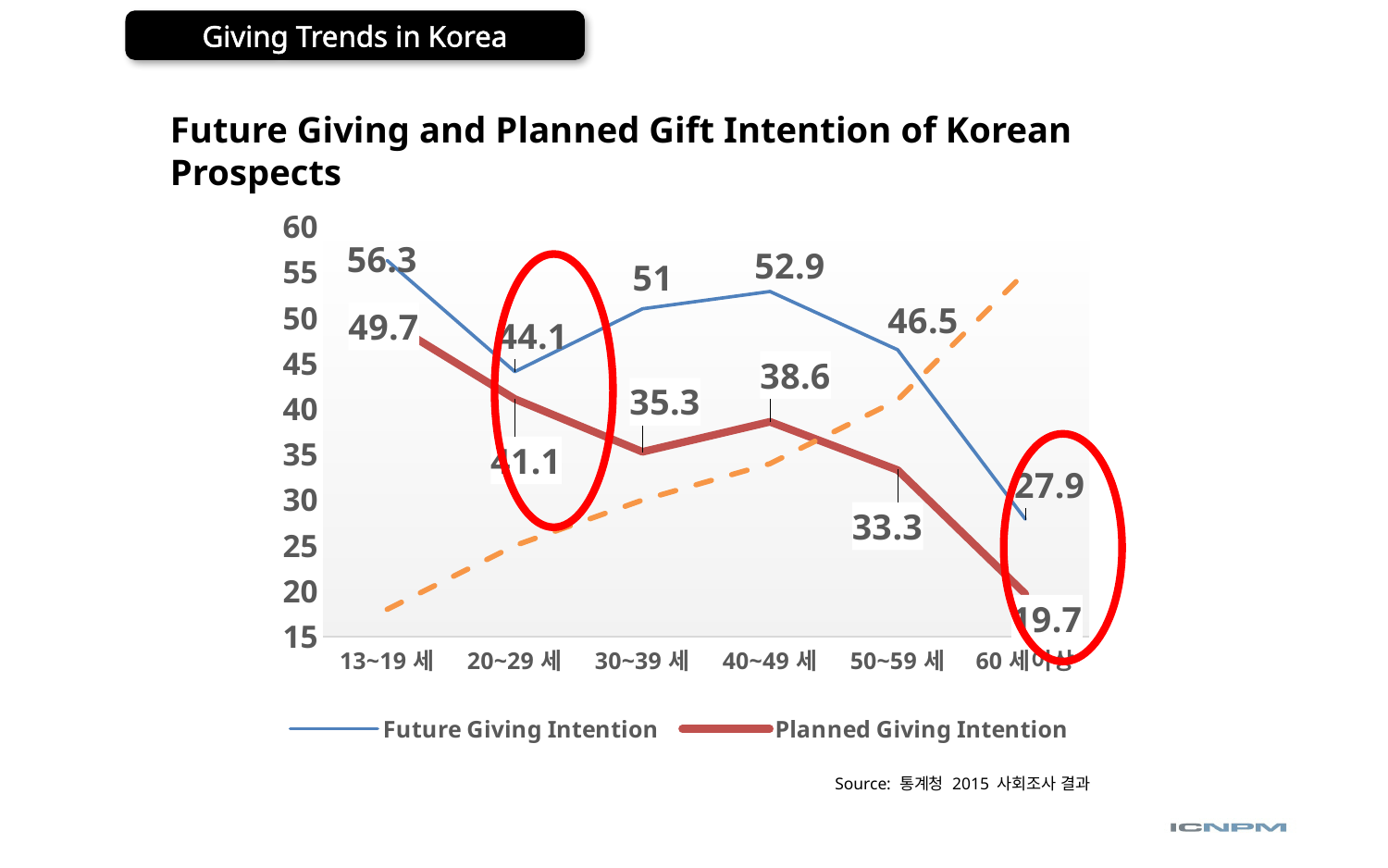
What is the difference between Future Giving Intention and Planned Giving Intention for the 50~59 세 age group? 13.2 Is the Future Giving Intention value for the 60 세이상 age group greater or less than 30? less Which is larger for the 20~29 세 age group: Future Giving Intention or Planned Giving Intention? Future Giving Intention Which age group has the highest Future Giving Intention value? 13~19 세 What is the Planned Giving Intention value for the 60 세이상 age group? 19.7 Which age group has the lowest Planned Giving Intention value? 60 세이상 What is the Future Giving Intention value for the 13~19 세 age group? 56.3 What type of chart is shown on the slide? line chart What is the title of the chart? Future Giving and Planned Gift Intention of Korean Prospects How many series does the legend list? 2 How many age groups are shown on the x axis? 6 What is the Planned Giving Intention value for the 40~49 세 age group? 38.6